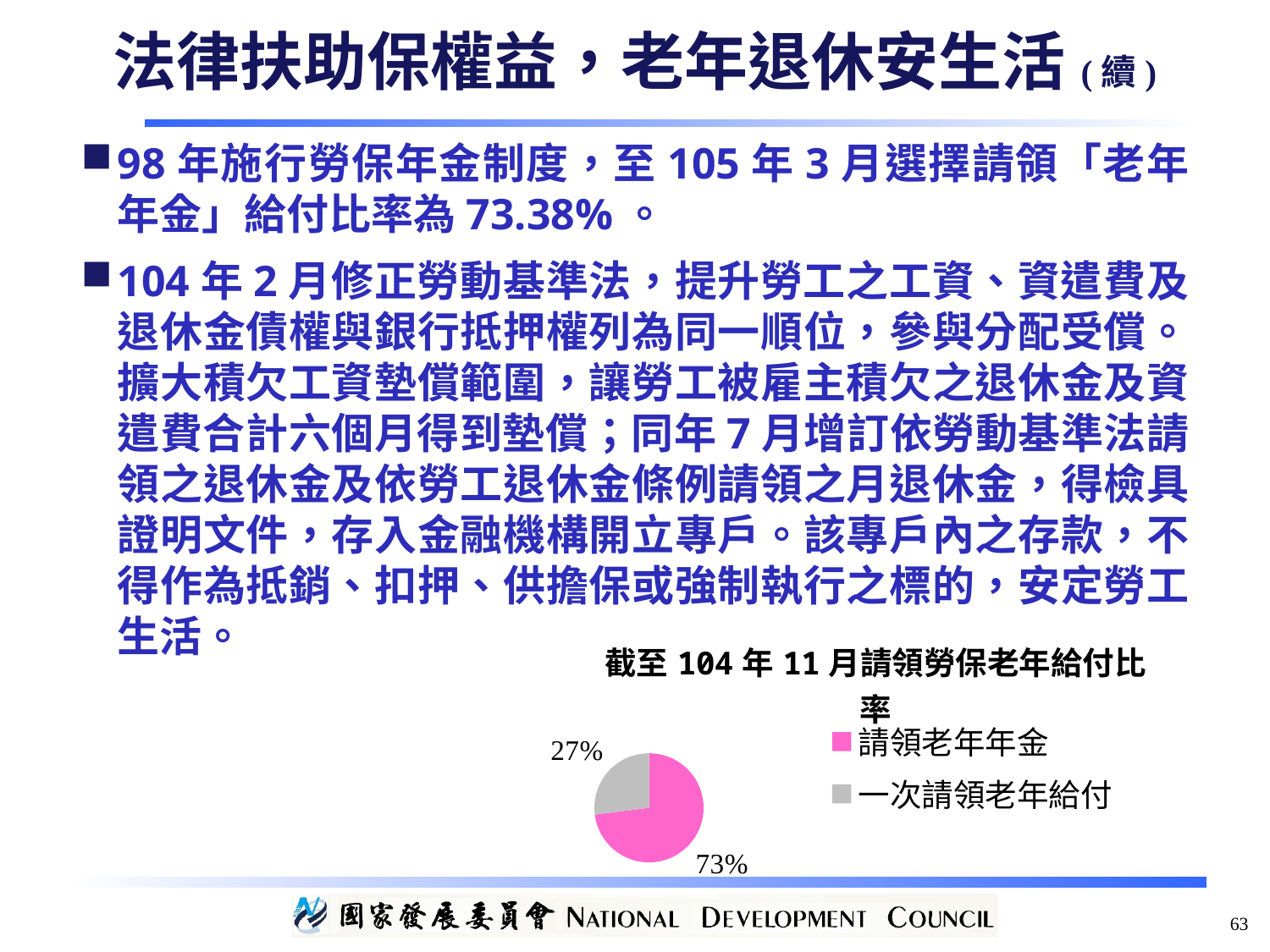
Which category has the smallest slice in the pie chart? 一次請領老年給付 What colour is the slice for 請領老年年金 in the pie chart? pink What is the title of the pie chart? 截至104年11月請領勞保老年給付比率 What kind of chart is shown on the slide? pie chart What share of the pie does 一次請領老年給付 represent? 27% Which is larger, the share for 請領老年年金 or the share for 一次請領老年給付? 請領老年年金 How many entries does the legend of the pie chart list? 2 What is the value for 請領老年年金 in the pie chart? 73% Which category has the largest slice in the pie chart? 請領老年年金 What is the value for 一次請領老年給付 in the pie chart? 27% How many slices does the pie chart have? 2 What is the difference between the shares of 請領老年年金 and 一次請領老年給付? 46%